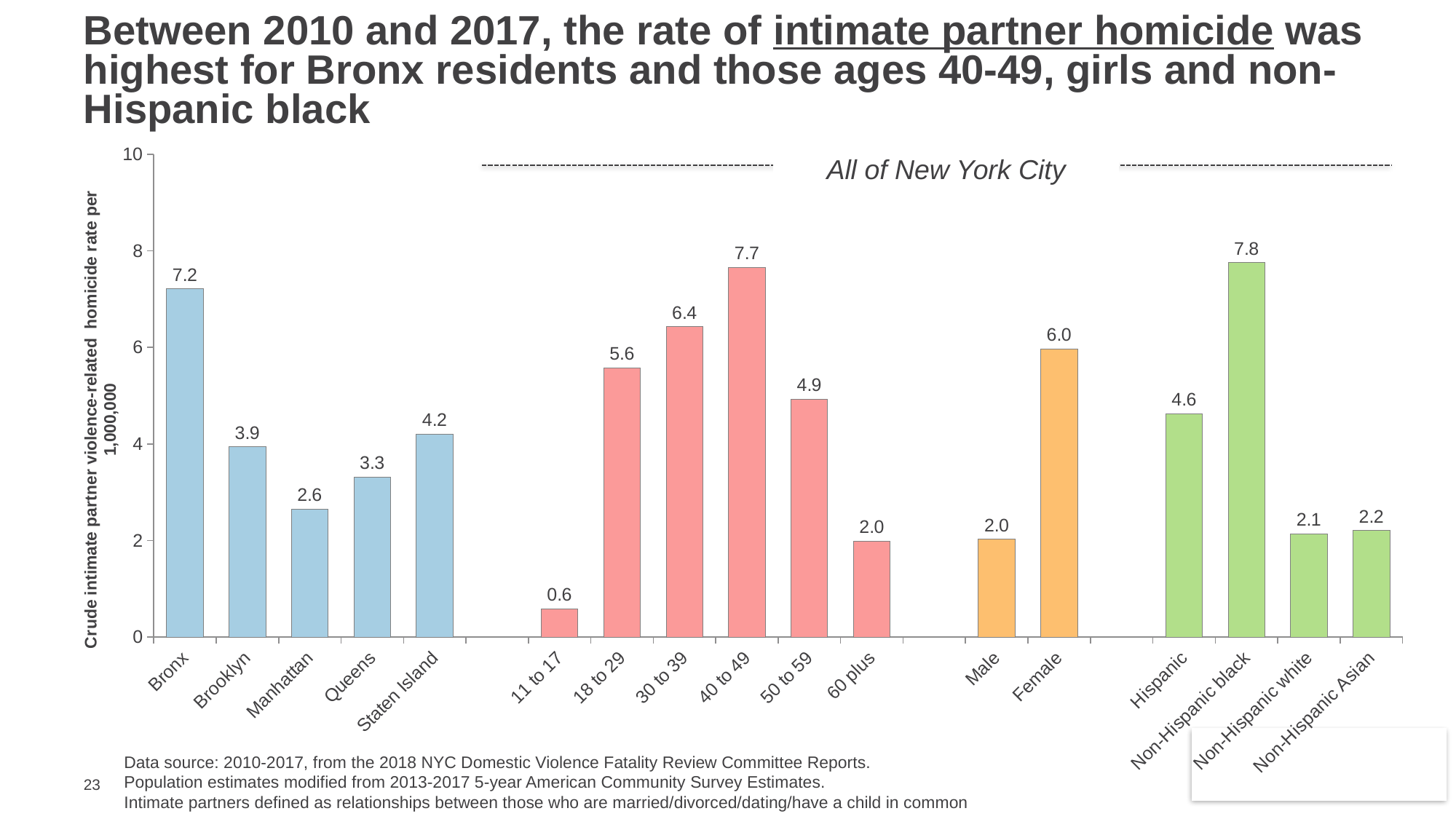
Which race/ethnicity group has the highest intimate partner homicide rate? Non-Hispanic black What type of chart is shown on the slide? Bar chart What is the intimate partner homicide rate for Non-Hispanic Asian? 2.2 What is the difference between the Bronx and Brooklyn intimate partner homicide rates? 3.3 What is the intimate partner homicide rate for Bronx residents? 7.2 How many bars are plotted on the chart in total? 17 Which age group has the lowest intimate partner homicide rate? 11 to 17 What is the intimate partner homicide rate for the 40 to 49 age group? 7.7 What is the difference between the Female and Male intimate partner homicide rates? 4.0 What is the intimate partner homicide rate for Female? 6.0 Which has a higher intimate partner homicide rate, Queens or Staten Island? Staten Island Which borough has the lowest intimate partner homicide rate? Manhattan